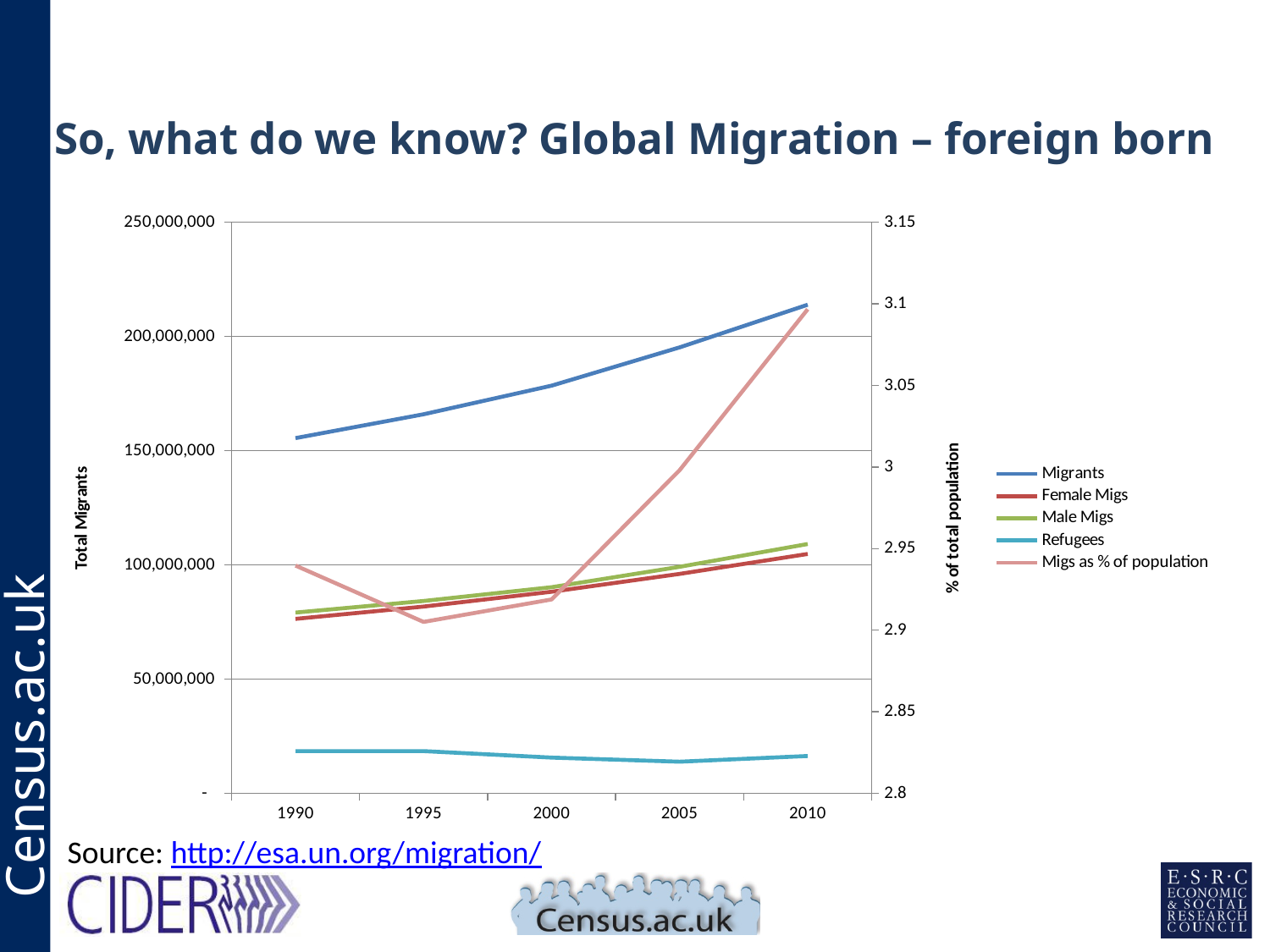
In which year is Migs as % of population highest? 2010 Is the value for Refugees in 1990 greater or less than 50,000,000? less Is the value for Female Migs in 1990 greater or less than 100,000,000? less Is the value for Migs as % of population in 1995 greater or less than 2.95? less How many years are marked along the x axis? 5 Does the Migrants line rise or fall from 1990 to 2010? Rises What kind of chart is shown on the slide? Line chart Which series is larger in 2010, Migrants or Refugees? Migrants How many series does the legend list? 5